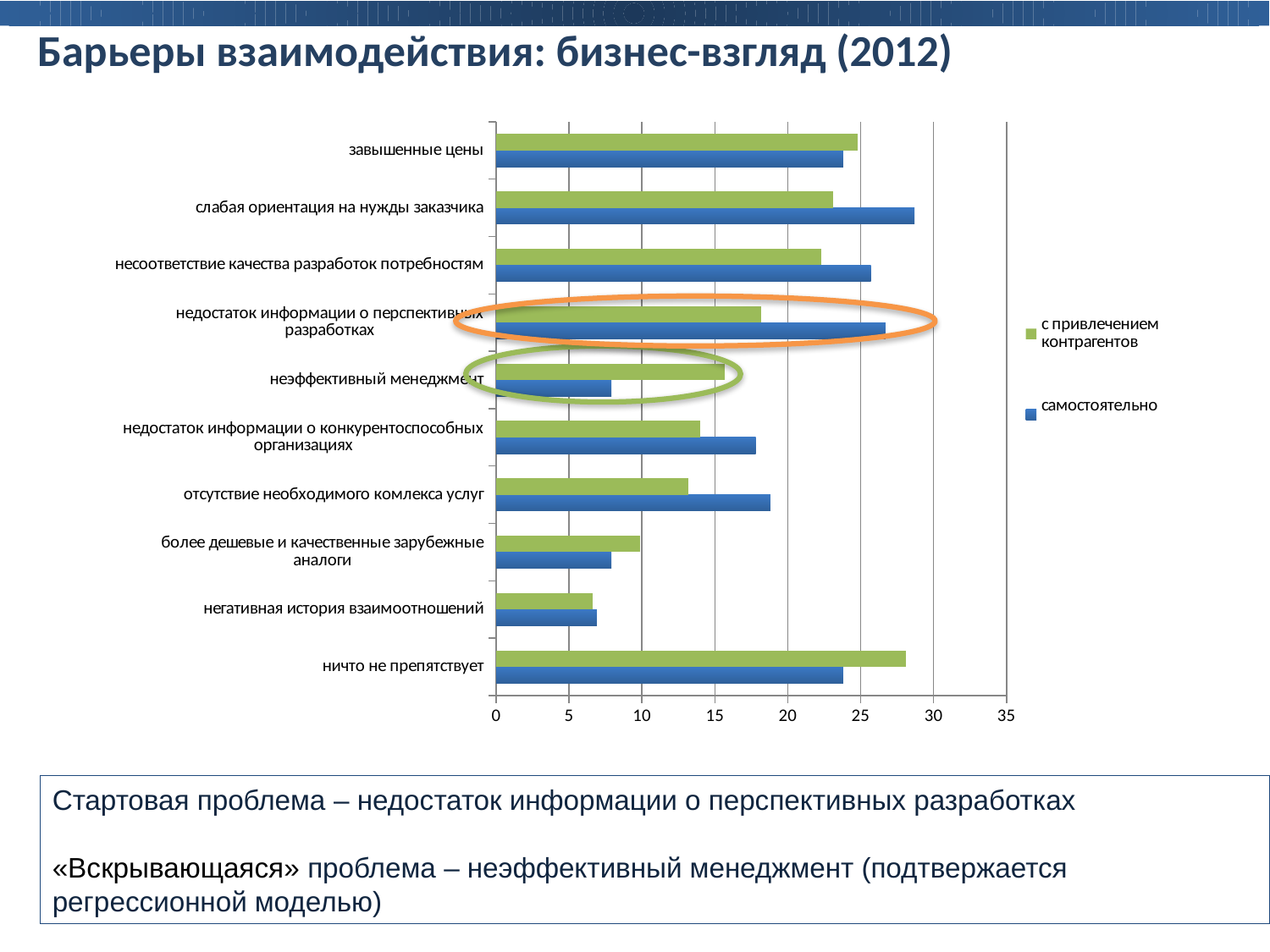
What kind of chart is shown on the slide? bar chart Is the value for "неэффективный менеджмент" in the series "самостоятельно" greater or less than 10? less Which category has the highest value for the series "самостоятельно"? слабая ориентация на нужды заказчика For "слабая ориентация на нужды заказчика", which series has the larger value: "с привлечением контрагентов" or "самостоятельно"? самостоятельно Which series is shown in blue in the chart legend? самостоятельно How many categories are plotted on the chart? 10 How many series does the chart legend list? 2 Is the value for "ничто не препятствует" in the series "с привлечением контрагентов" greater or less than 25? greater Is the value for "недостаток информации о перспективных разработках" in the series "самостоятельно" greater or less than 25? greater For "неэффективный менеджмент", which series has the larger value: "с привлечением контрагентов" or "самостоятельно"? с привлечением контрагентов Which category has the lowest value for the series "с привлечением контрагентов"? негативная история взаимоотношений Which category has the highest value for the series "с привлечением контрагентов"? ничто не препятствует